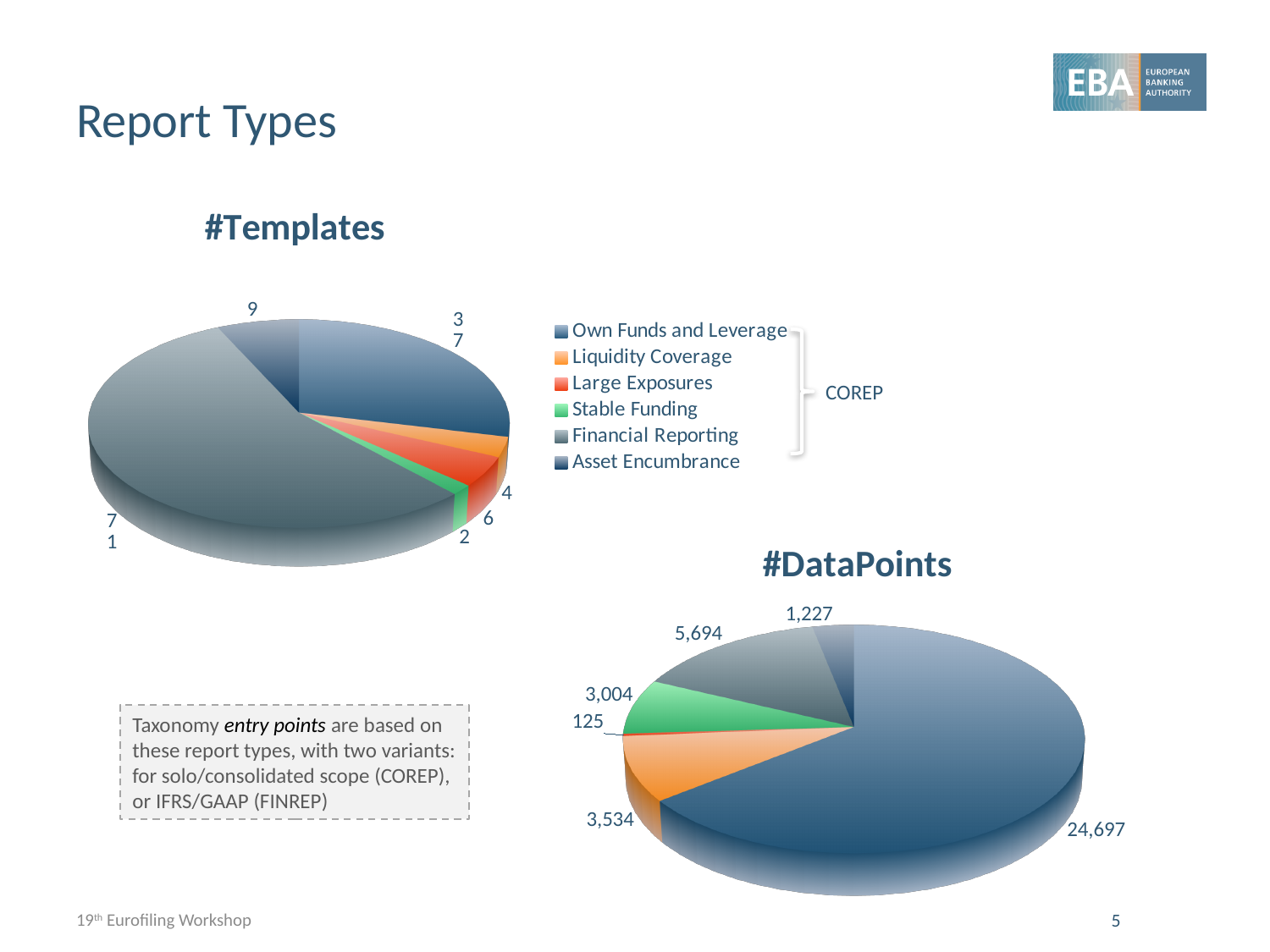
In the #DataPoints chart, how many data points does Large Exposures have? 125 In the #Templates chart, how many templates does Asset Encumbrance have? 9 How many report types does the legend list? 6 In the #DataPoints chart, how many data points does Financial Reporting have? 5,694 What kind of chart is the #DataPoints chart? pie chart In the #DataPoints chart, how many data points does Own Funds and Leverage have? 24,697 In the #DataPoints chart, which has more data points, Stable Funding or Liquidity Coverage? Liquidity Coverage In the #DataPoints chart, what is the difference between the data points for Financial Reporting and Liquidity Coverage? 2,160 In the #DataPoints chart, which report type has the most data points? Own Funds and Leverage In the #DataPoints chart, which report type has the fewest data points? Large Exposures In the #Templates chart, how many more templates does Large Exposures have than Stable Funding? 4 In the #Templates chart, how many templates does Large Exposures have? 6